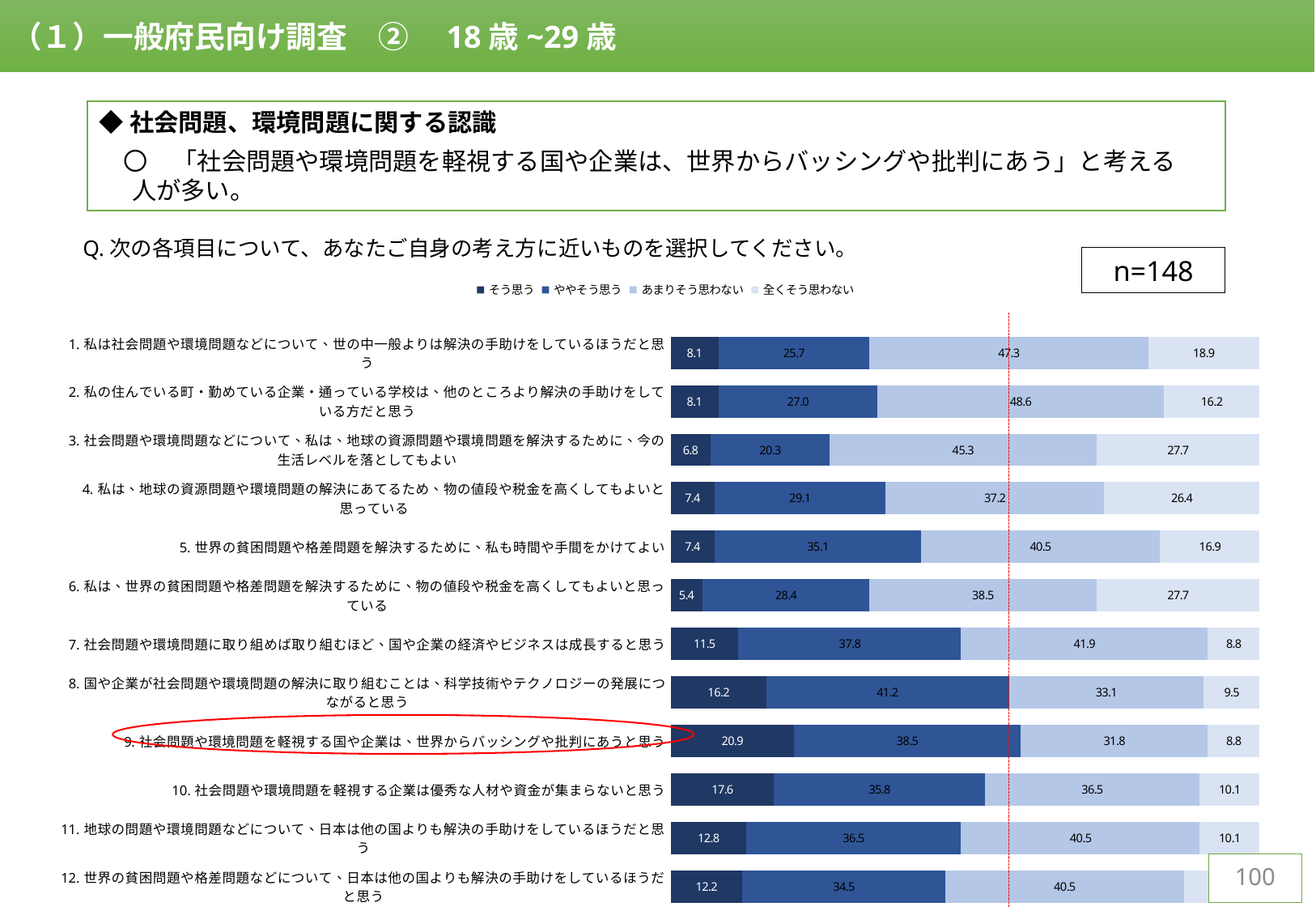
How many items (categories) are shown in the chart? 12 What is the combined value of そう思う and ややそう思う for item 9? 59.4 What is the value of 全くそう思わない for item 7? 8.8 What is the value of そう思う for item 9 (社会問題や環境問題を軽視する国や企業は、世界からバッシングや批判にあうと思う)? 20.9 What is the difference between the ややそう思う values of item 8 and item 9? 2.7 Which is larger, the 全くそう思わない value for item 3 or for item 4? Item 3 What is the value of あまりそう思わない for item 1? 47.3 Which item has the lowest そう思う value? Item 6 What kind of chart is shown on the slide? Stacked bar chart How many series does the legend list? 4 What is the sample size (n) shown on the slide? n=148 Which item has the highest そう思う value? Item 9